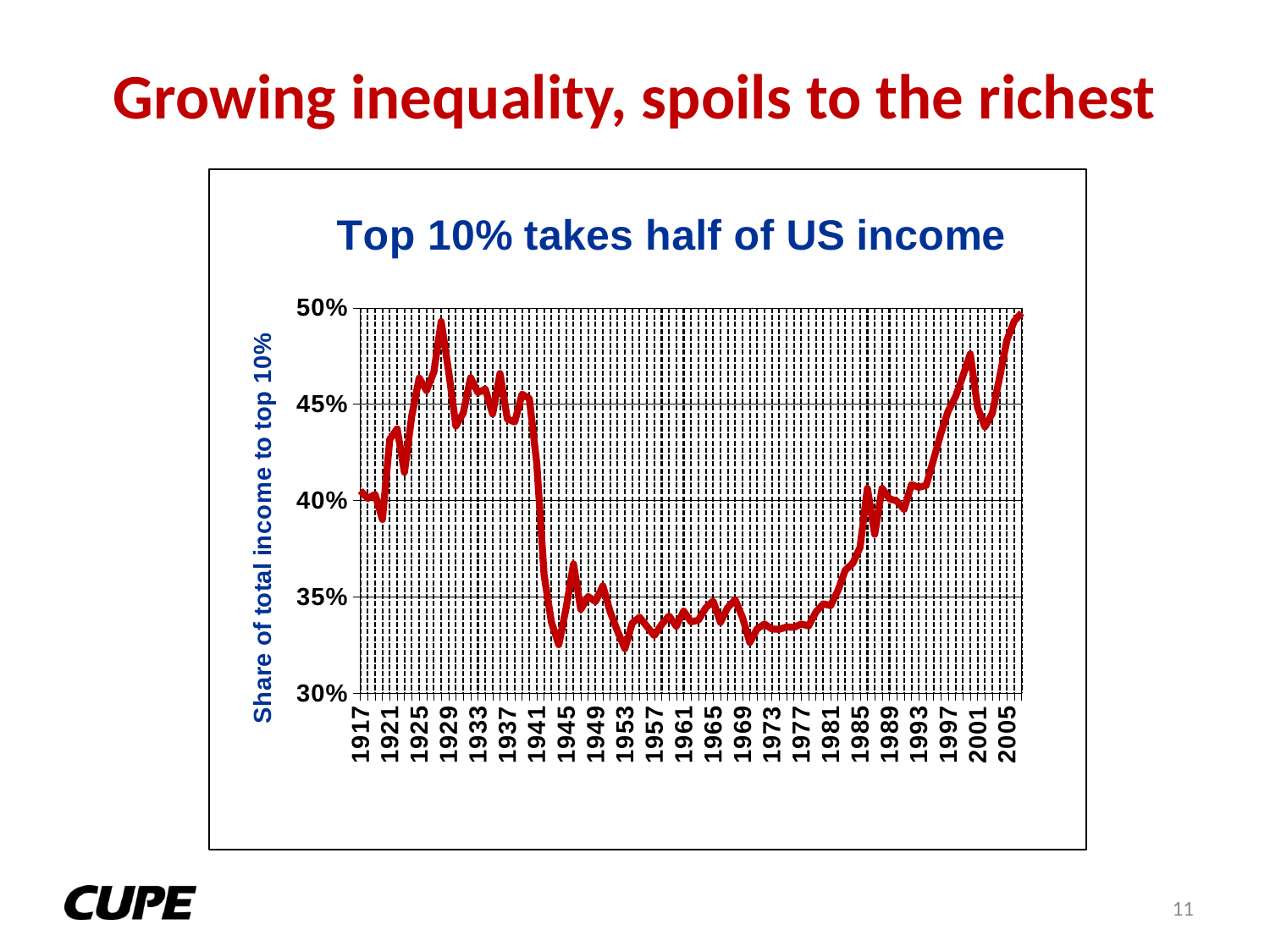
Is the value for 1973 greater or less than 35%? less What kind of chart is shown on the slide? line chart What is the label on the vertical axis of the chart? Share of total income to top 10% How many year labels are shown on the horizontal axis? 23 Do the values generally rise or fall between 1977 and 2005? rise Which year has the larger value, 1929 or 1953? 1929 Is the value for 1929 greater or less than 45%? greater Is the value for 1953 greater or less than 35%? less What is the title of the chart? Top 10% takes half of US income Which year has the larger value, 1973 or 2005? 2005